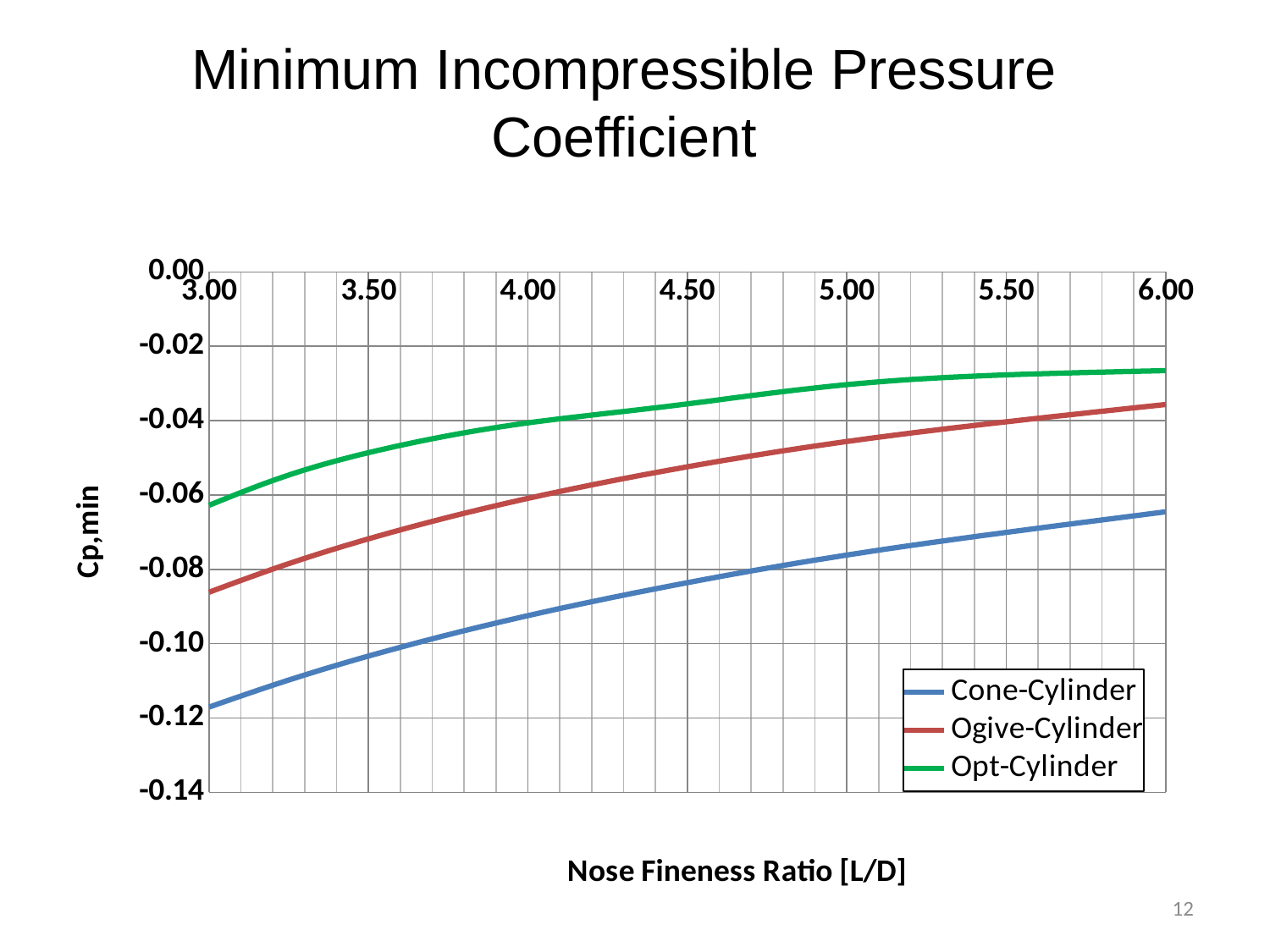
Which series has the lowest (most negative) Cp,min values across the whole range of nose fineness ratio? Cone-Cylinder Is the Cp,min value for Opt-Cylinder at a nose fineness ratio of 6.00 greater or less than -0.04? greater Does the Cp,min value for Cone-Cylinder rise or fall as the nose fineness ratio increases from 3.00 to 6.00? rise How many series does the legend list? 3 Is the Cp,min value for Cone-Cylinder at a nose fineness ratio of 6.00 greater or less than -0.08? greater Is the Cp,min value for Cone-Cylinder at a nose fineness ratio of 3.00 greater or less than -0.10? less What is the label of the x axis of the chart? Nose Fineness Ratio [L/D] At a nose fineness ratio of 4.00, which series has the larger Cp,min value, Cone-Cylinder or Ogive-Cylinder? Ogive-Cylinder Which series has the highest (least negative) Cp,min values across the whole range of nose fineness ratio? Opt-Cylinder What kind of chart is shown on the slide? line chart Which colour is used for the Ogive-Cylinder series? red